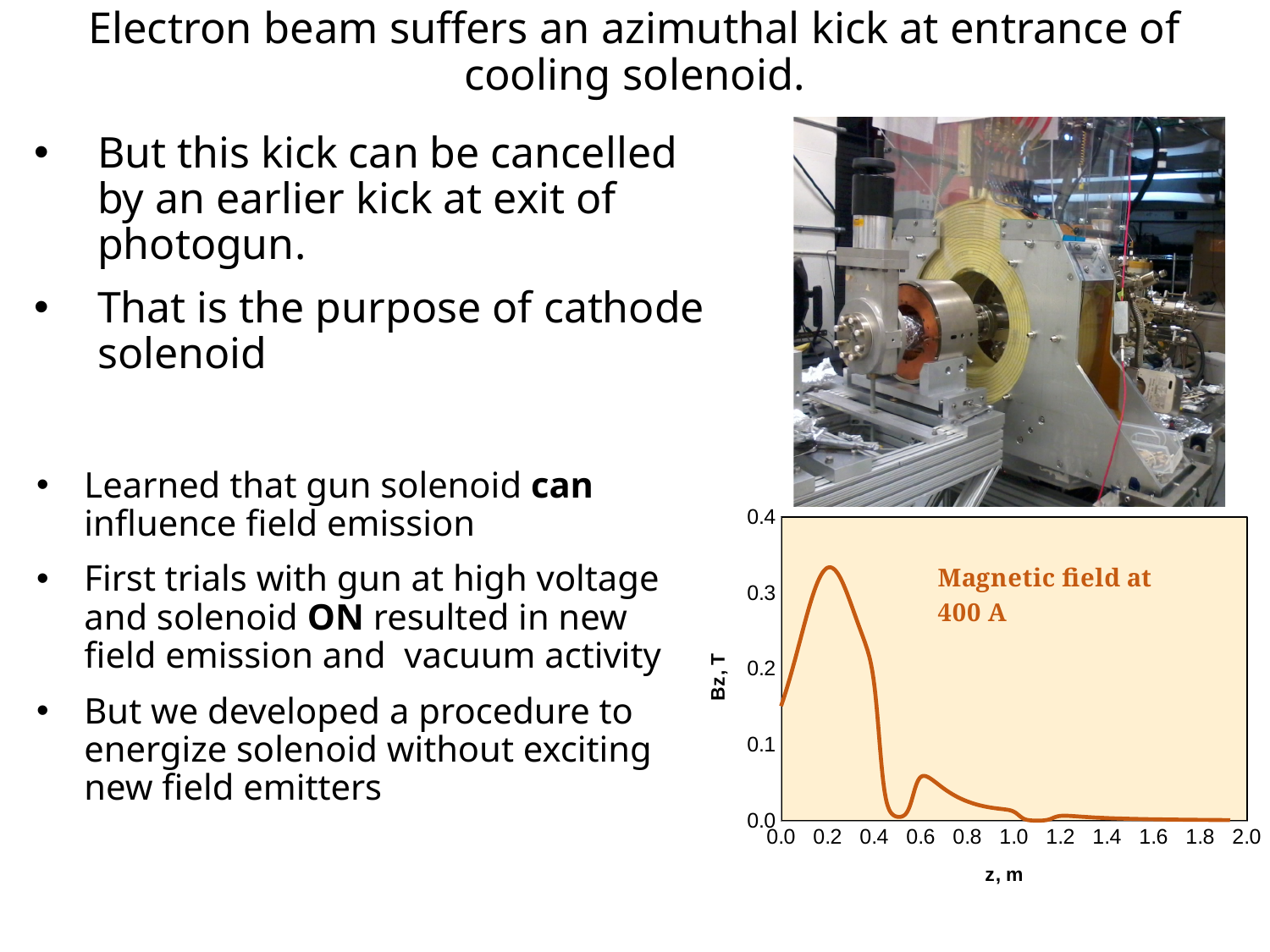
Is the value of Bz at z = 0.6 m greater or less than 0.1? less Is the value of Bz at z = 0.0 m greater or less than 0.2? less What is the label of the x axis of the chart? z, m What is the highest tick value shown on the x axis of the chart? 2.0 Is the value of Bz at z = 1.0 m greater or less than 0.1? less What kind of chart is shown at the bottom right of the slide? line chart Which is larger on the chart, Bz at z = 0.2 m or Bz at z = 1.0 m? Bz at z = 0.2 m Does Bz rise or fall along the x axis from z = 0.2 m to z = 2.0 m? fall What is the label of the y axis of the chart? Bz, T